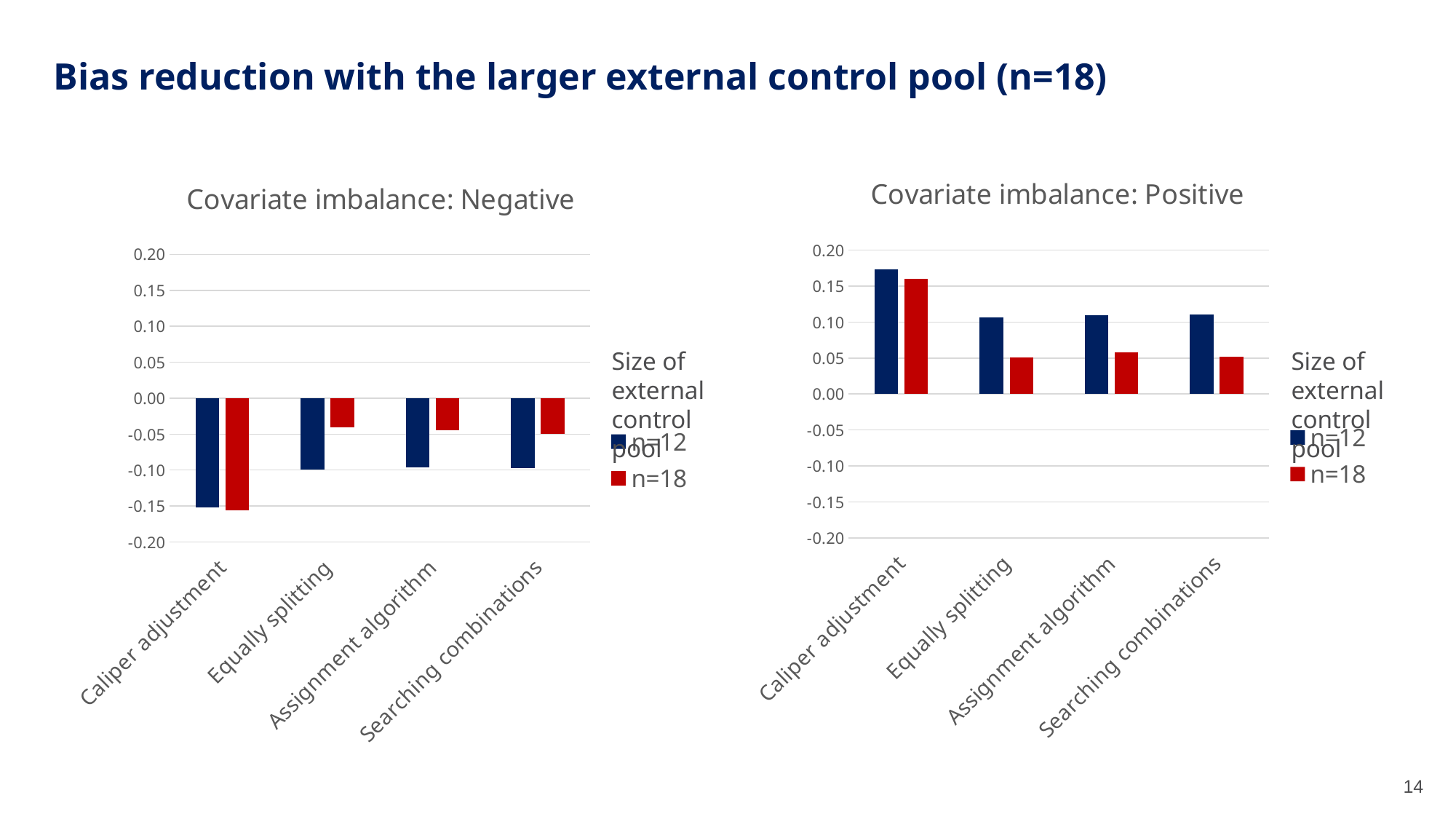
In the 'Covariate imbalance: Negative' chart, is the n=18 value for Assignment algorithm greater or less than -0.10? greater In the 'Covariate imbalance: Positive' chart, which category has the highest n=12 value? Caliper adjustment In the 'Covariate imbalance: Negative' chart, which category has the lowest (most negative) n=18 value? Caliper adjustment In the 'Covariate imbalance: Positive' chart, is the n=18 value for Equally splitting greater or less than 0.10? less How many categories are shown on the x axis of the 'Covariate imbalance: Positive' chart? 4 In the 'Covariate imbalance: Negative' chart, which is larger for Searching combinations: the n=12 value or the n=18 value? n=18 In the 'Covariate imbalance: Negative' chart, is the n=12 value for Caliper adjustment greater or less than -0.10? less What is the legend title shown on the 'Covariate imbalance: Positive' chart? Size of external control pool What kind of chart is the 'Covariate imbalance: Negative' chart? bar chart In the 'Covariate imbalance: Positive' chart, which is larger for Equally splitting: the n=12 value or the n=18 value? n=12 How many series does the legend of the 'Covariate imbalance: Negative' chart list? 2